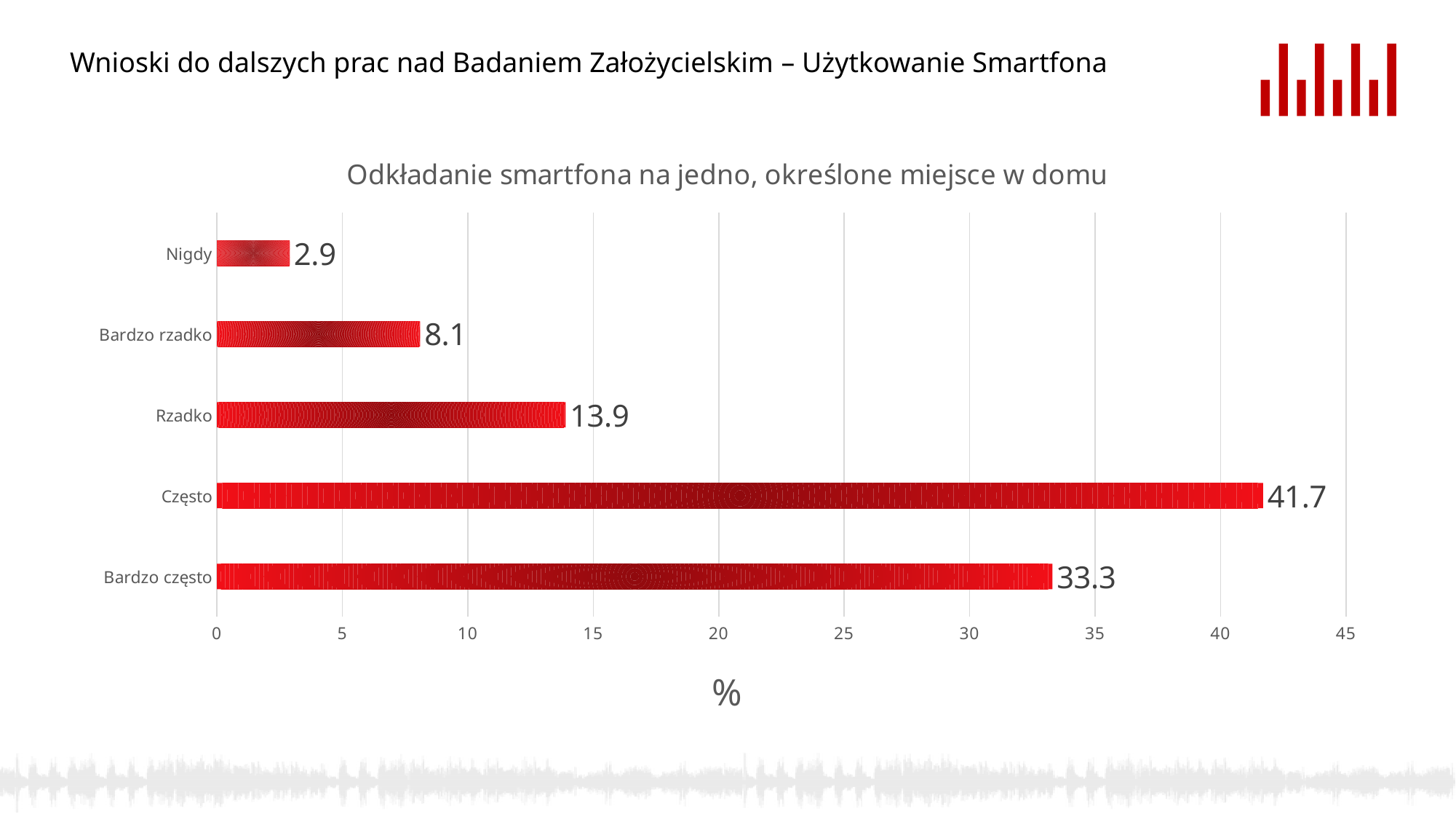
What is the value for Często? 41.7 What is the difference between the values for Często and Bardzo często? 8.4 What is the value for Bardzo rzadko? 8.1 What is the title of the chart? Odkładanie smartfona na jedno, określone miejsce w domu What kind of chart is shown on the slide? bar chart Which is larger, the value for Rzadko or the value for Bardzo rzadko? Rzadko How many categories are shown in the chart? 5 What is the value for Nigdy? 2.9 Which category has the lowest value? Nigdy Is the value for Bardzo często greater or less than 30? greater What is the value for Rzadko? 13.9 Which category has the highest value? Często